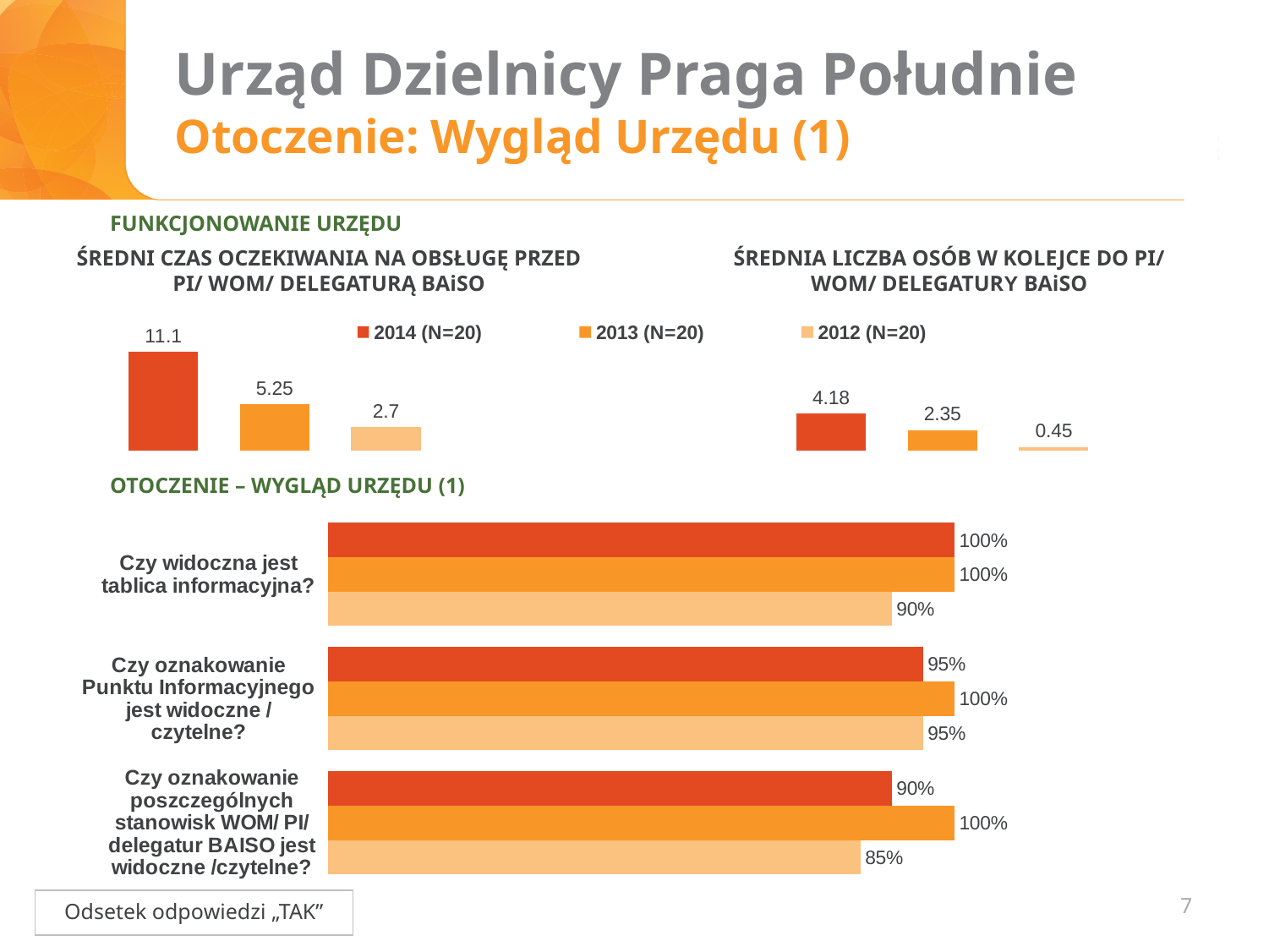
What type of chart is the bottom chart 'OTOCZENIE – WYGLĄD URZĘDU (1)'? Bar chart In the chart 'ŚREDNIA LICZBA OSÓB W KOLEJCE DO PI/ WOM/ DELEGATURY BAiSO', what is the value for 2013? 2.35 In the bottom chart 'OTOCZENIE – WYGLĄD URZĘDU (1)', what is the 2012 value for 'Czy widoczna jest tablica informacyjna?'? 90% How many question categories are shown in the bottom chart 'OTOCZENIE – WYGLĄD URZĘDU (1)'? 3 In the bottom chart 'OTOCZENIE – WYGLĄD URZĘDU (1)', what is the 2014 value for 'Czy oznakowanie poszczególnych stanowisk WOM/ PI/ delegatur BAISO jest widoczne /czytelne?'? 90% In the chart 'ŚREDNIA LICZBA OSÓB W KOLEJCE DO PI/ WOM/ DELEGATURY BAiSO', what is the difference between the 2014 and 2012 values? 3.73 In the chart 'ŚREDNI CZAS OCZEKIWANIA NA OBSŁUGĘ PRZED PI/ WOM/ DELEGATURĄ BAiSO', what is the difference between the 2014 and 2013 values? 5.85 In the chart 'ŚREDNI CZAS OCZEKIWANIA NA OBSŁUGĘ PRZED PI/ WOM/ DELEGATURĄ BAiSO', what is the value for 2014? 11.1 In the chart 'ŚREDNI CZAS OCZEKIWANIA NA OBSŁUGĘ PRZED PI/ WOM/ DELEGATURĄ BAiSO', what is the value for 2012? 2.7 In the bottom chart 'OTOCZENIE – WYGLĄD URZĘDU (1)', which is larger for 'Czy oznakowanie Punktu Informacyjnego jest widoczne / czytelne?': the 2014 value or the 2013 value? 2013 In the chart 'ŚREDNIA LICZBA OSÓB W KOLEJCE DO PI/ WOM/ DELEGATURY BAiSO', which year has the lowest value? 2012 How many series does the legend at the top of the slide list? 3